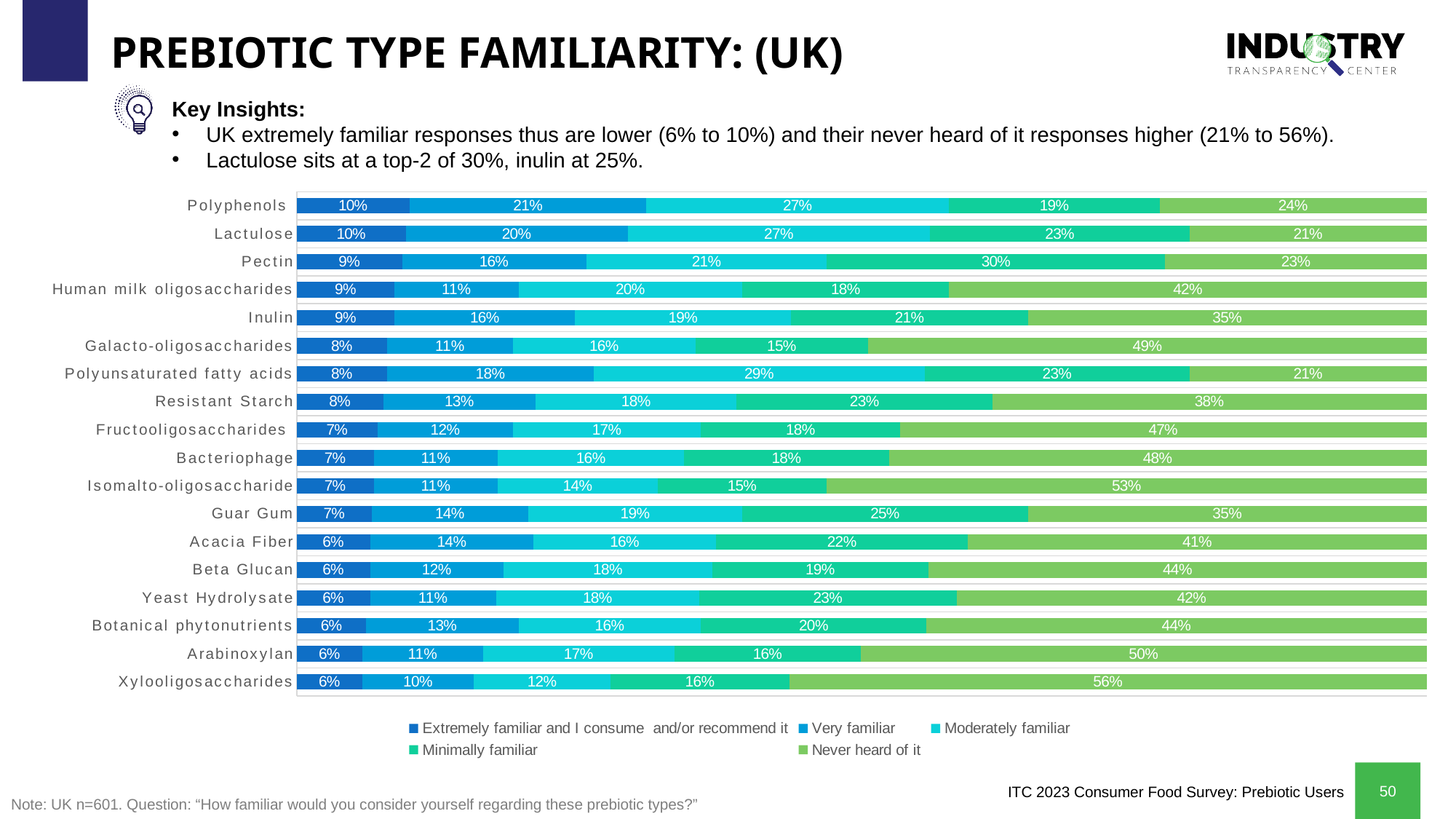
What kind of chart is shown on the slide? Stacked bar chart What is the difference between the 'Never heard of it' values for Xylooligosaccharides and Polyphenols? 32 percentage points What is the 'Never heard of it' value for Xylooligosaccharides? 56% Which prebiotic type has the highest 'Never heard of it' value? Xylooligosaccharides What is the 'Minimally familiar' value for Pectin? 30% Which has a larger 'Never heard of it' value, Galacto-oligosaccharides or Inulin? Galacto-oligosaccharides How many prebiotic types are listed on the chart? 18 What is the 'Moderately familiar' value for Polyunsaturated fatty acids? 29% What is the title of the chart slide? PREBIOTIC TYPE FAMILIARITY: (UK) Which prebiotic type has the highest 'Moderately familiar' value? Polyunsaturated fatty acids How many series does the legend list? 5 What is the combined value of 'Extremely familiar and I consume and/or recommend it' and 'Very familiar' for Lactulose? 30%